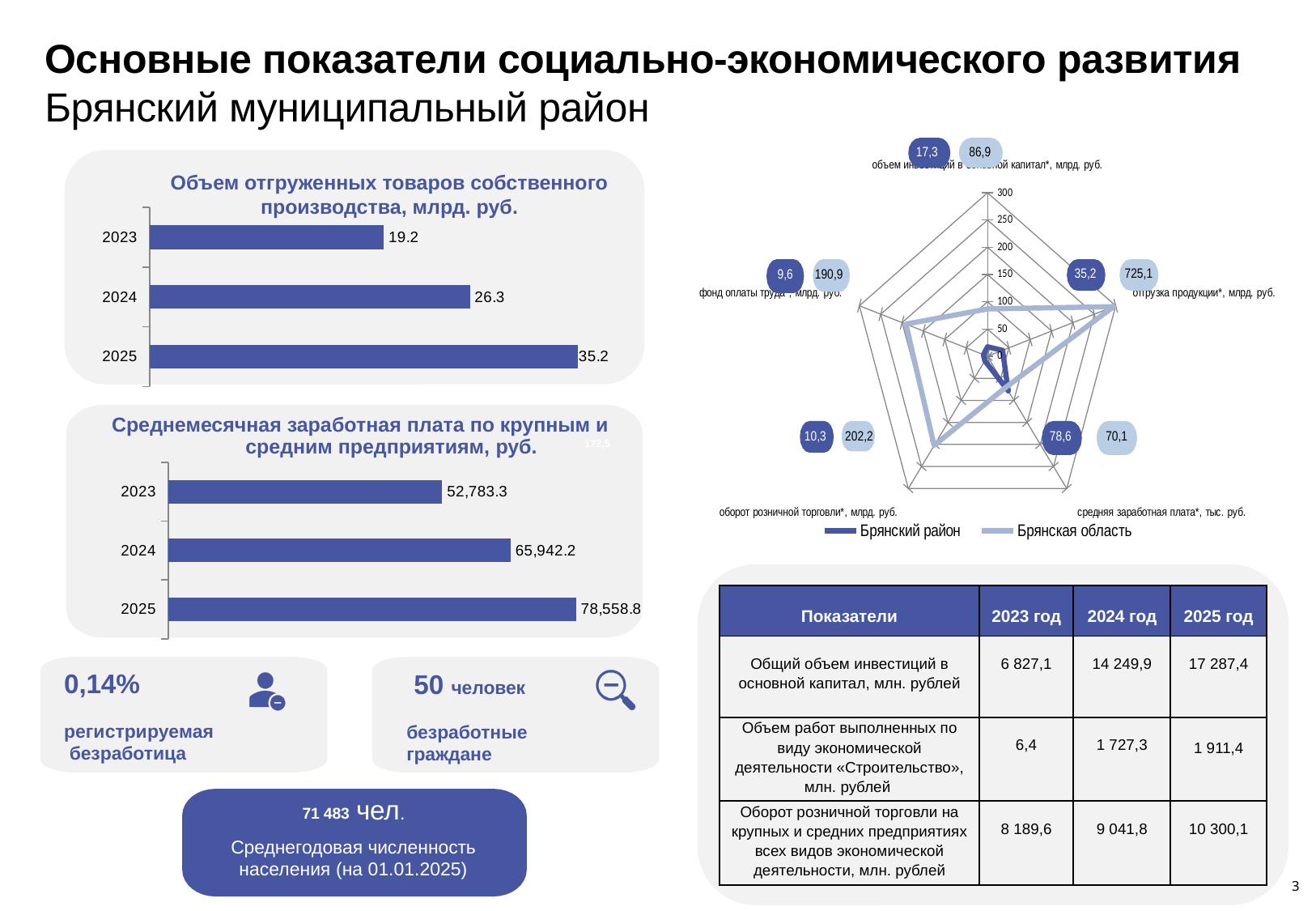
What type of chart is 'Объем отгруженных товаров собственного производства, млрд. руб.'? bar chart In the chart 'Объем отгруженных товаров собственного производства, млрд. руб.', which year has the highest value? 2025 In the chart 'Среднемесячная заработная плата по крупным и средним предприятиям, руб.', what is the value for 2023? 52,783.3 In the chart 'Объем отгруженных товаров собственного производства, млрд. руб.', what is the value for 2024? 26.3 In the chart 'Среднемесячная заработная плата по крупным и средним предприятиям, руб.', what is the difference between the 2025 and 2024 values? 12,616.6 In the chart 'Среднемесячная заработная плата по крупным и средним предприятиям, руб.', which year has the lowest value? 2023 In the chart 'Среднемесячная заработная плата по крупным и средним предприятиям, руб.', how many years are shown? 3 In the chart 'Объем отгруженных товаров собственного производства, млрд. руб.', what is the difference between the 2025 and 2023 values? 16.0 In the radar chart on the right, how many series does the legend list? 2 In the radar chart on the right, what is the value of 'средняя заработная плата, тыс. руб.' for Брянский район? 78,6 In the radar chart on the right, which series is shown in dark blue? Брянский район In the chart 'Объем отгруженных товаров собственного производства, млрд. руб.', do the values rise or fall from 2023 to 2025? rise